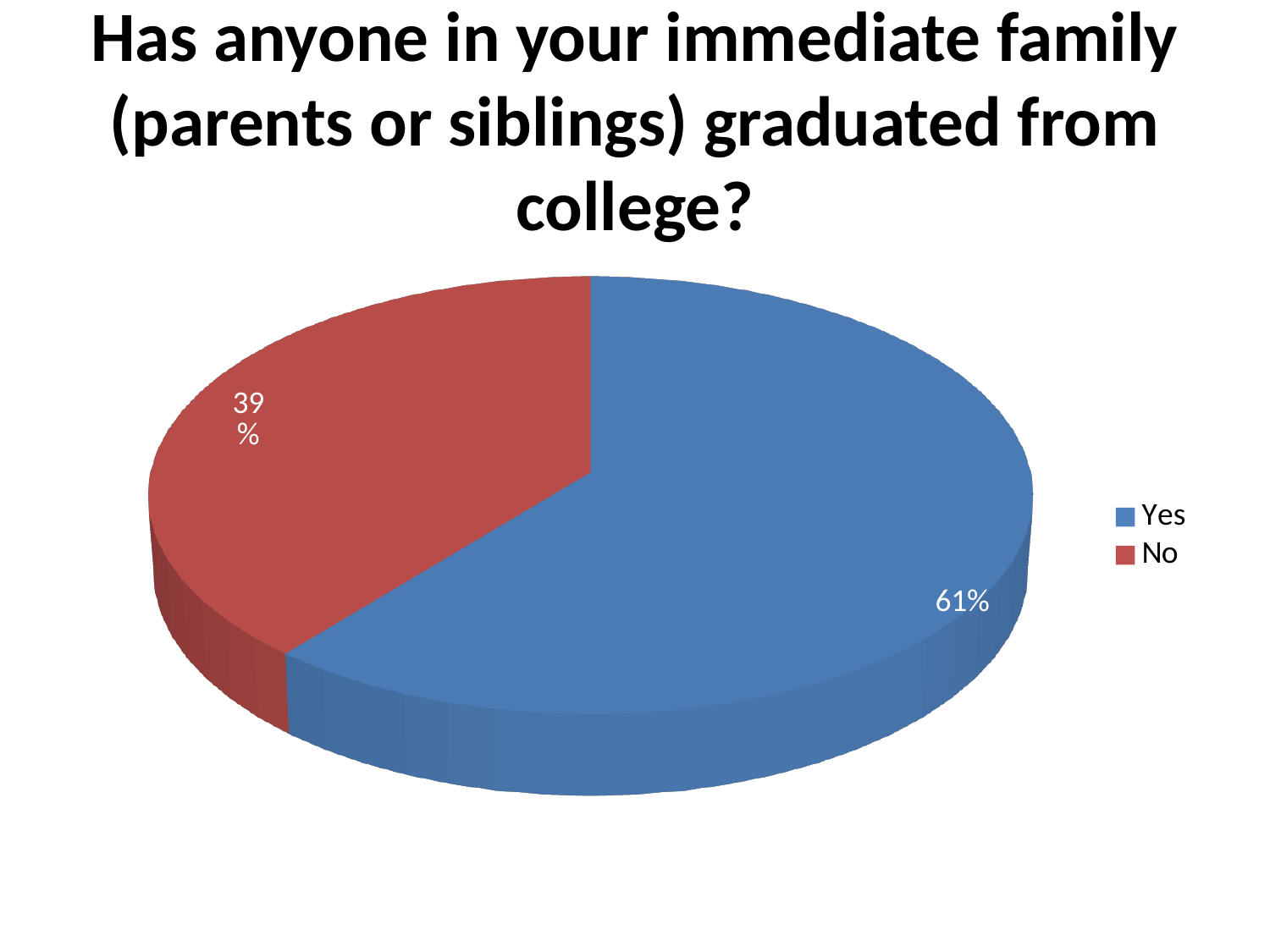
What kind of chart is shown on the slide? Pie chart Which slice is larger, Yes or No? Yes What is the title of the chart? Has anyone in your immediate family (parents or siblings) graduated from college? What is the difference in percentage points between the Yes and No slices? 22 Which response has the largest share of the pie? Yes How many entries does the legend list? 2 Which response has the smallest share of the pie? No What share of the pie does the No slice represent? 39% What colour is the Yes slice? Blue What percentage of respondents answered No? 39% How many slices does the pie chart have? 2 What percentage of respondents answered Yes? 61%